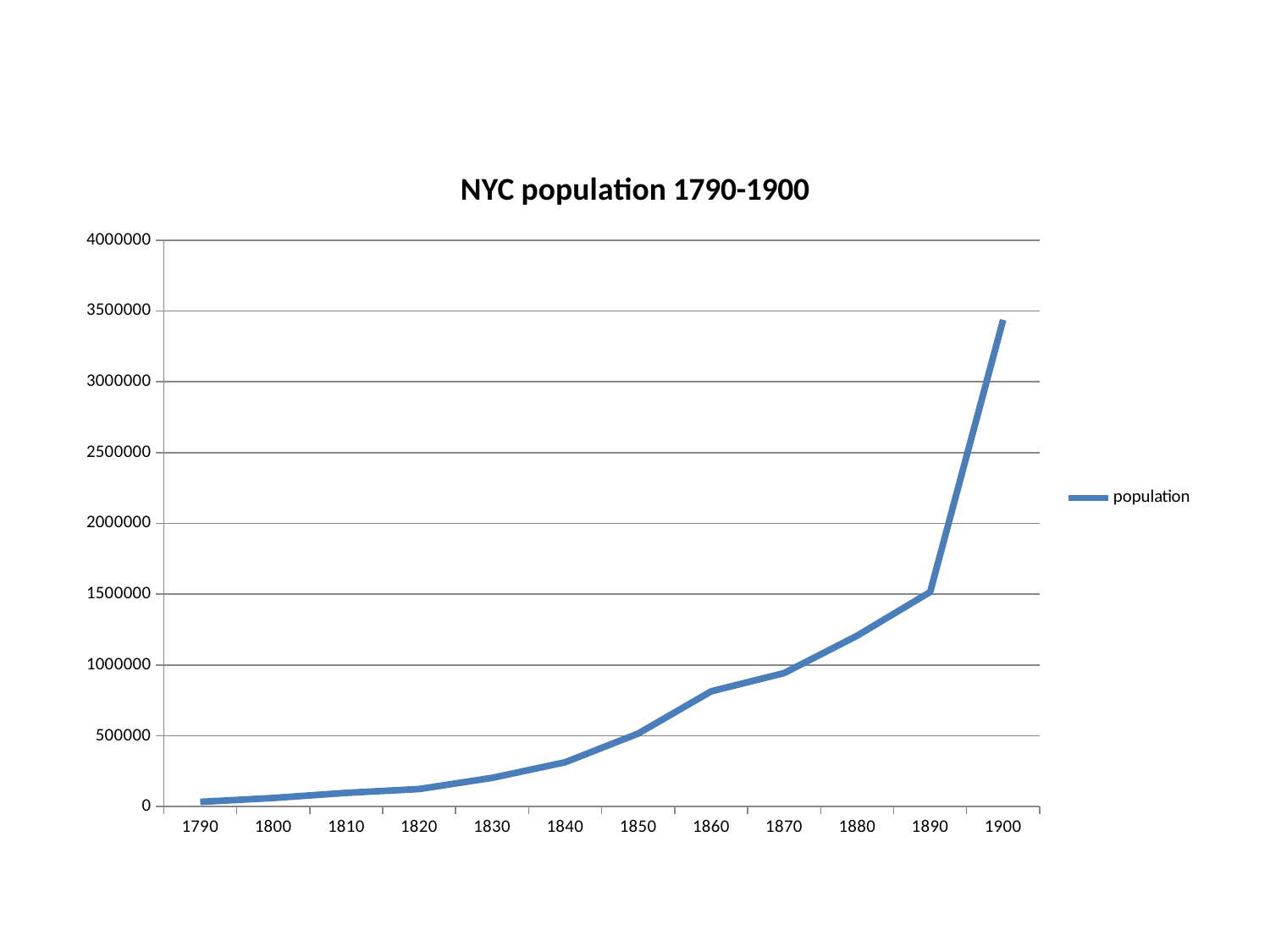
How many series does the legend list? 1 Is the population value for 1890 greater or less than 2000000? less Is the population value for 1870 greater or less than 1000000? less Which year has the highest population value? 1900 Does the population rise or fall from 1790 to 1900? rise What kind of chart is shown on the slide? line chart What is the name of the series shown in the legend? population Which year has the lowest population value? 1790 Is the population value for 1900 greater or less than 3000000? greater Which year has the larger population value, 1860 or 1880? 1880 How many years are marked along the x axis? 12 What is the title of the chart? NYC population 1790-1900